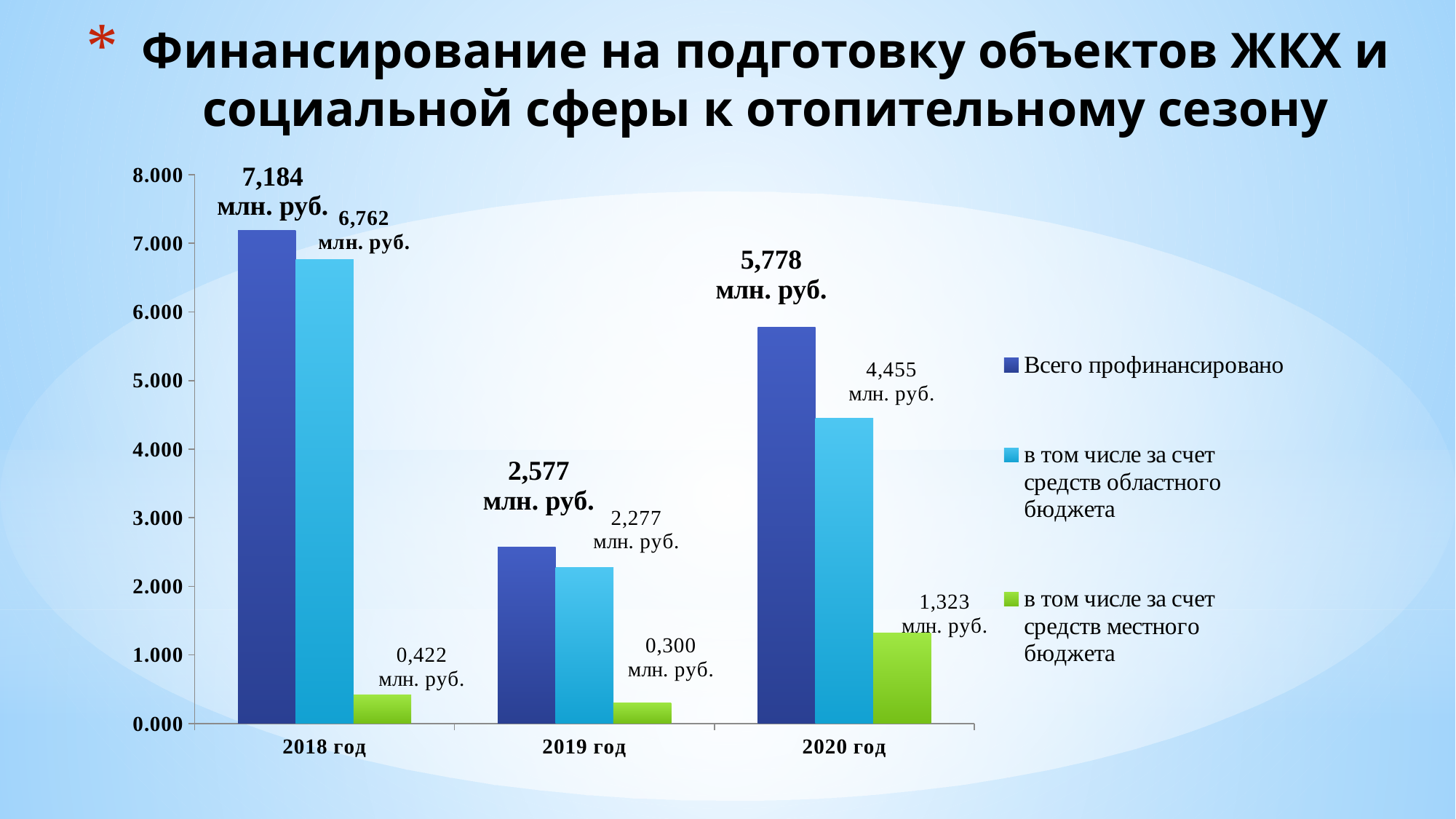
Which year has the highest value of "Всего профинансировано"? 2018 год What is the value for "в том числе за счет средств областного бюджета" in 2020 год? 4,455 млн. руб. What is the value of "Всего профинансировано" for 2018 год? 7,184 млн. руб. Which is larger: "в том числе за счет средств областного бюджета" in 2019 год or in 2020 год? 2020 год What is the difference between "Всего профинансировано" in 2018 год and in 2020 год? 1,406 млн. руб. Which year has the lowest value of "в том числе за счет средств местного бюджета"? 2019 год How many years are shown on the x axis of the chart? 3 How many series does the legend list? 3 What is the difference between "Всего профинансировано" and "в том числе за счет средств областного бюджета" in 2020 год? 1,323 млн. руб. What kind of chart is shown on the slide? Bar chart Is the value of "Всего профинансировано" for 2019 год greater or less than 3.000? less What is the value for "в том числе за счет средств местного бюджета" in 2019 год? 0,300 млн. руб.